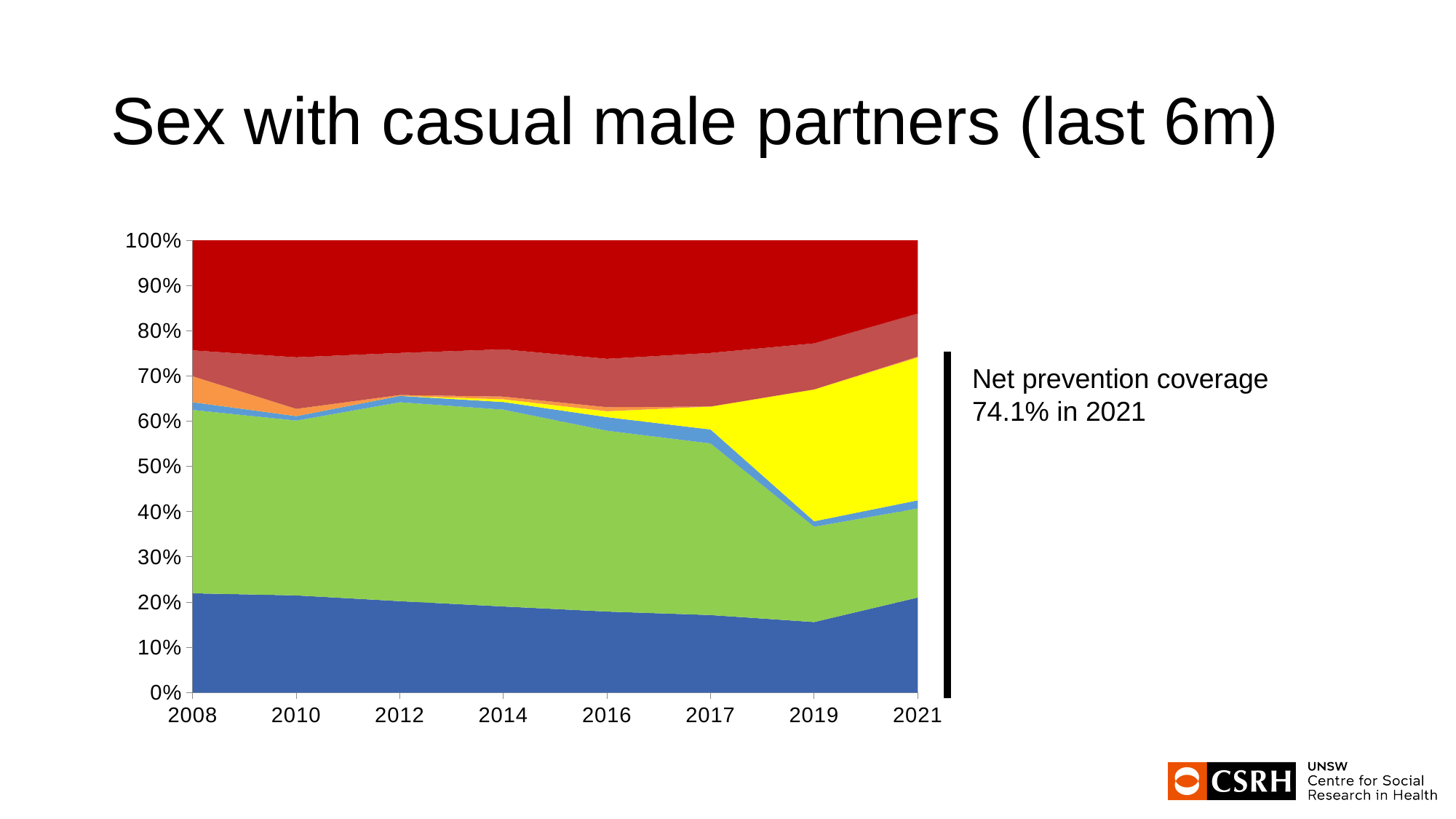
What kind of chart is shown on the slide? Stacked area chart What net prevention coverage figure for 2021 is stated next to the chart? 74.1% What is the first year shown on the x axis of the chart? 2008 Is the top of the dark blue (bottom) area in 2019 greater or less than 20%? less Is the top of the dark blue (bottom) area in 2008 greater or less than 20%? greater Does the top boundary of the dark blue (bottom) area rise or fall from 2008 to 2019? fall What is the last year shown on the x axis of the chart? 2021 What is the title of the slide containing the chart? Sex with casual male partners (last 6m) How many years are marked along the x axis of the chart? 8 What is the maximum value shown on the y axis of the chart? 100% Is the top of the green area in 2008 greater or less than 60%? greater